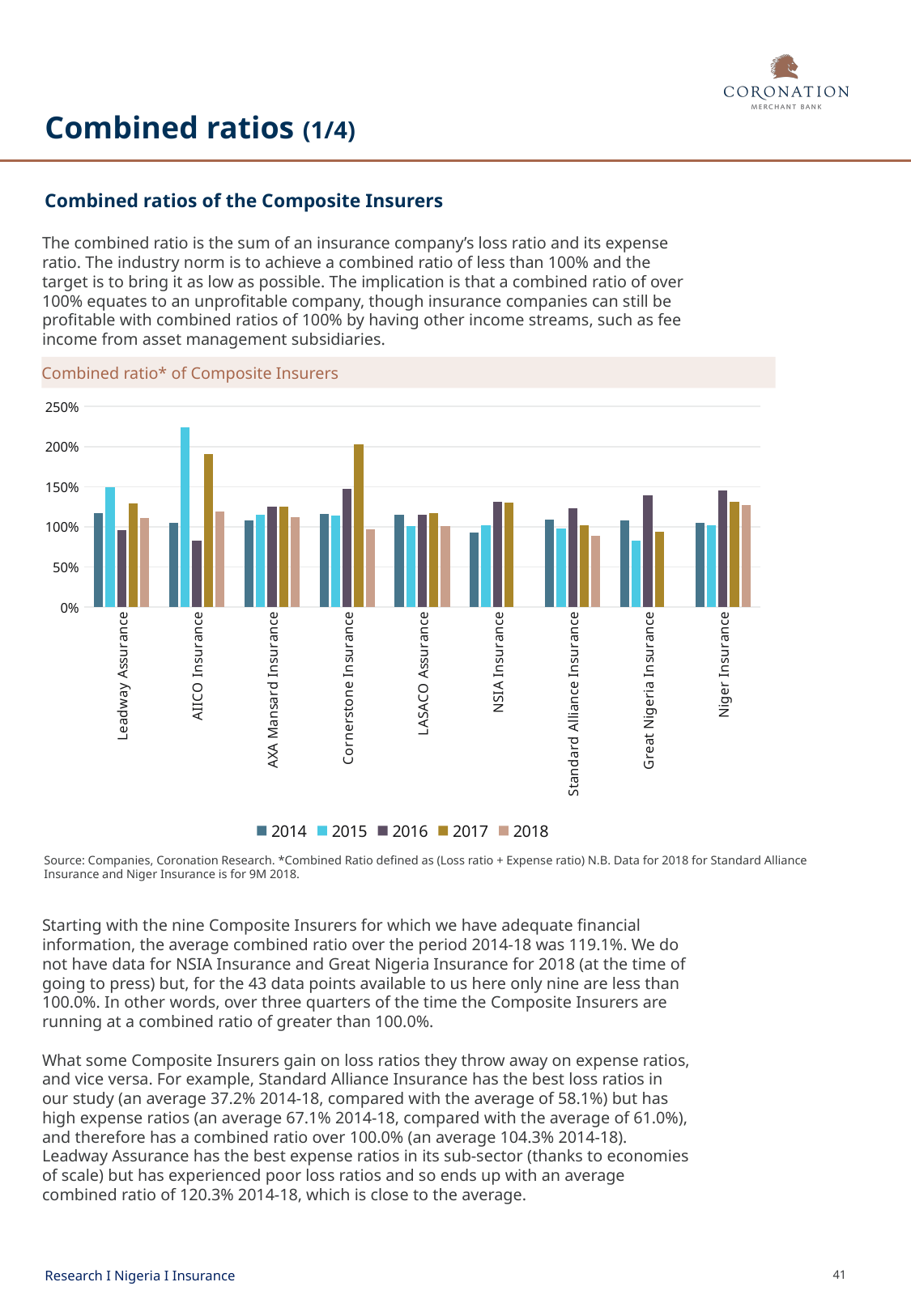
Which insurer has the highest combined ratio for 2015? AIICO Insurance How many insurers are shown on the x axis of the chart? 9 Is the 2015 value for AIICO Insurance greater or less than 200%? greater Which year has the lowest combined ratio for AIICO Insurance? 2016 Is the 2017 value for Cornerstone Insurance greater or less than 150%? greater For Leadway Assurance, which is larger: the 2015 value or the 2016 value? 2015 Is the 2016 value for AIICO Insurance greater or less than 100%? less What kind of chart is shown on the slide? Bar chart How many series does the chart's legend list? 5 Which year has the highest combined ratio for Cornerstone Insurance? 2017 What is the title of the chart? Combined ratio* of Composite Insurers